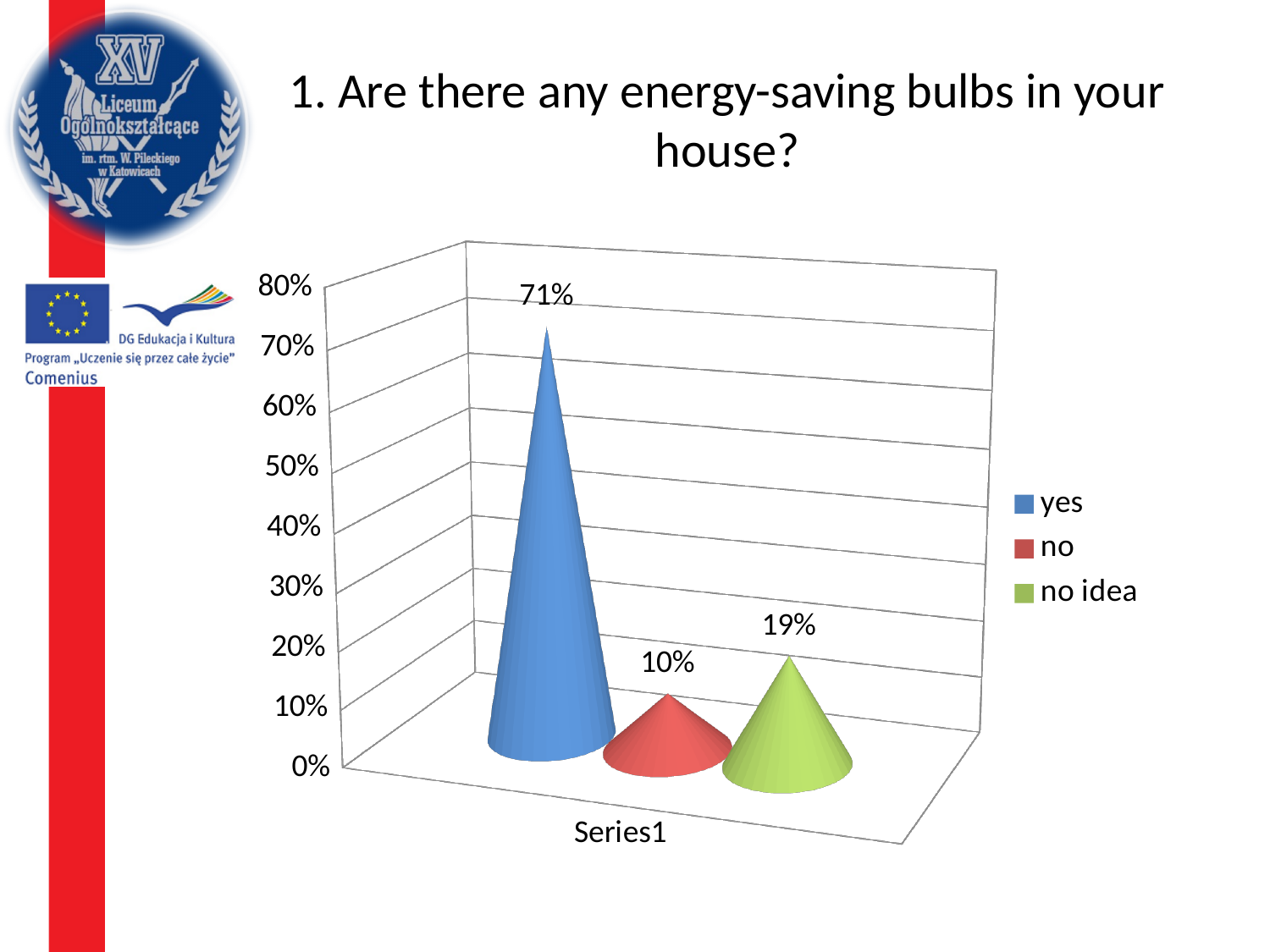
What is the difference between the "no idea" and "no" percentages? 9% Is the value for "yes" greater or less than 50%? greater Which answer has the highest percentage? yes What colour represents the "no idea" answer in the chart? green Which is larger, the percentage for "no" or for "no idea"? no idea Which answer has the lowest percentage? no What percentage of respondents answered "no idea"? 19% What percentage of respondents answered "no"? 10% How many answer options does the legend list? 3 What percentage of respondents answered "yes"? 71% What is the difference between the "yes" and "no" percentages? 61% What kind of chart is shown on the slide? bar chart